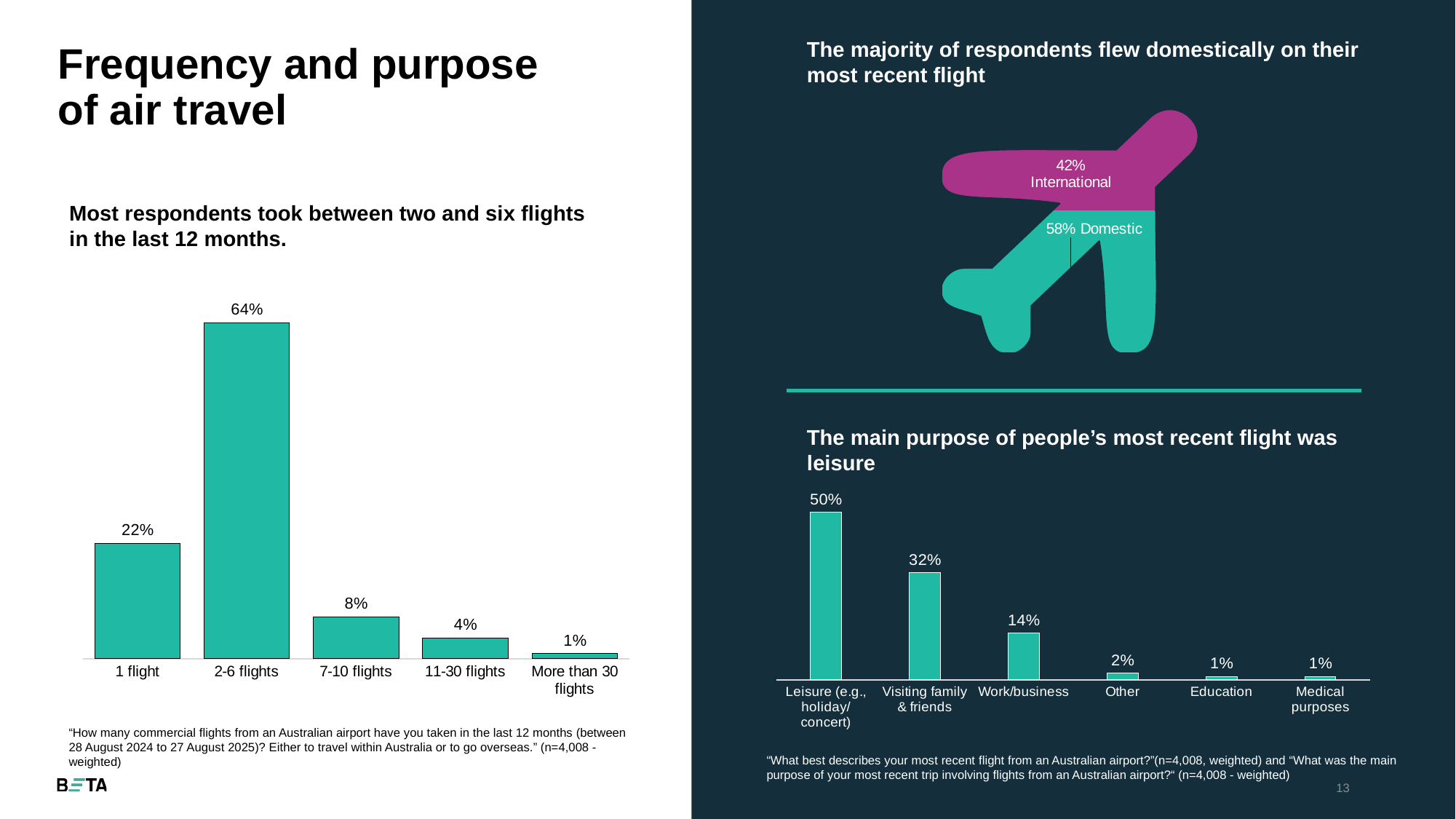
In the aeroplane graphic at the top right, what percentage of respondents flew domestically on their most recent flight? 58% In the left-hand chart of flights taken in the last 12 months, which category has the lowest value? More than 30 flights In the bottom-right chart of the main purpose of the most recent flight, what percentage is shown for Work/business? 14% In the bottom-right chart of the main purpose of the most recent flight, how many categories are shown? 6 In the left-hand chart of flights taken in the last 12 months, what percentage of respondents took 2-6 flights? 64% In the bottom-right chart of the main purpose of the most recent flight, what is the difference between Leisure and Visiting family & friends? 18% In the left-hand chart of flights taken in the last 12 months, what is the difference between the values for 2-6 flights and 1 flight? 42% In the left-hand chart of flights taken in the last 12 months, what percentage of respondents took 1 flight? 22% In the left-hand chart of flights taken in the last 12 months, how many categories are shown? 5 In the bottom-right chart of the main purpose of the most recent flight, which category has the highest value? Leisure (e.g., holiday/concert) What kind of chart is the left-hand chart of flights taken in the last 12 months? Bar chart In the bottom-right chart of the main purpose of the most recent flight, which is larger: Visiting family & friends or Work/business? Visiting family & friends